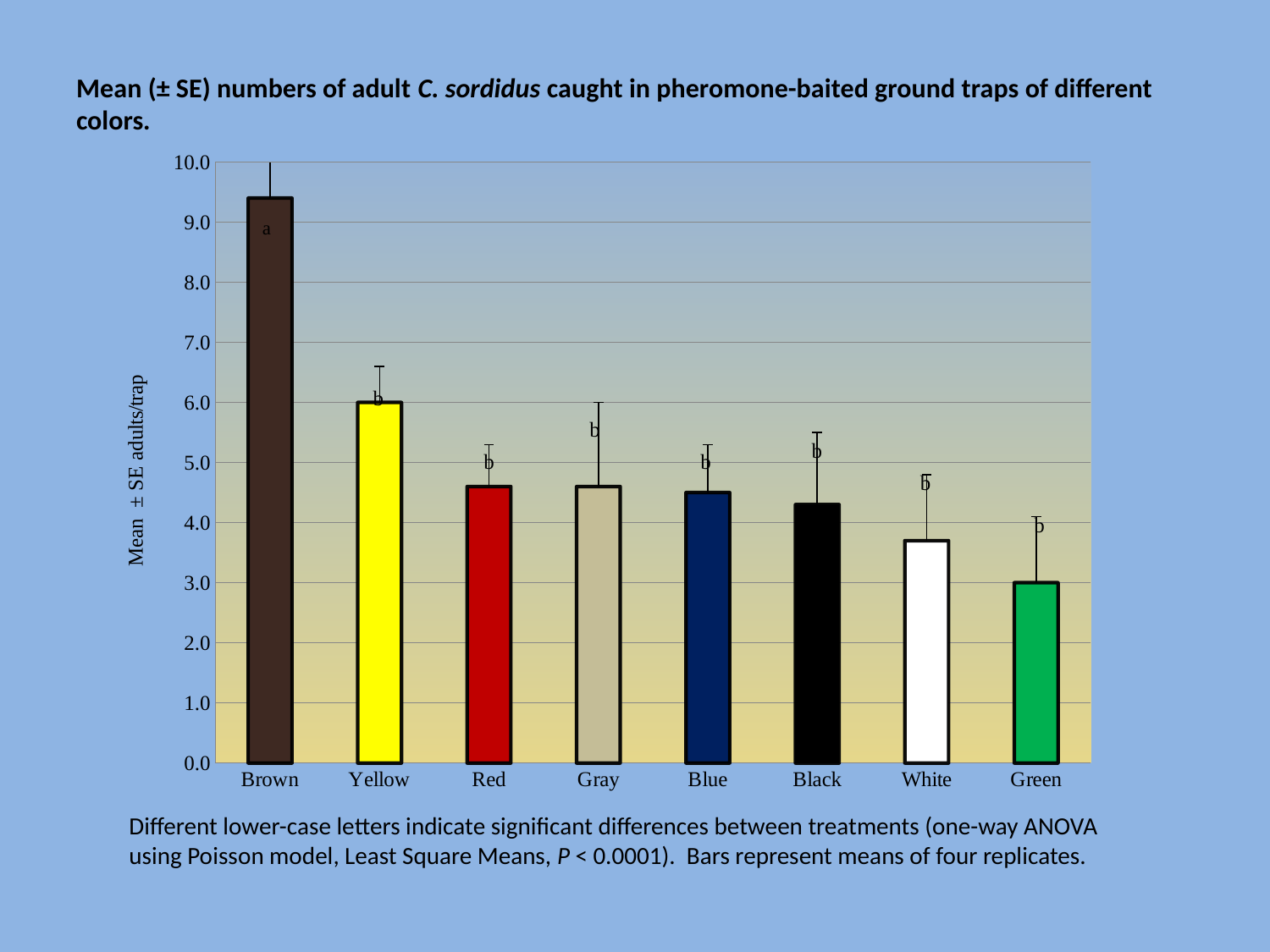
Which trap color has the lowest mean number of adults per trap? Green Do the bar values generally rise or fall from Brown to Green along the x axis? fall What kind of chart is shown on the slide? bar chart Which has a larger mean number of adults per trap, Brown or Yellow? Brown Which trap color has the highest mean number of adults per trap? Brown Is the value for Brown greater or less than 9.0? greater Is the value for White greater or less than 4.0? less What is the mean number of adults per trap for Green? 3.0 What is the mean number of adults per trap for Yellow? 6.0 What is the label on the y axis? Mean ± SE adults/trap How many trap colors are shown on the x axis? 8 Is the value for Black greater or less than 5.0? less